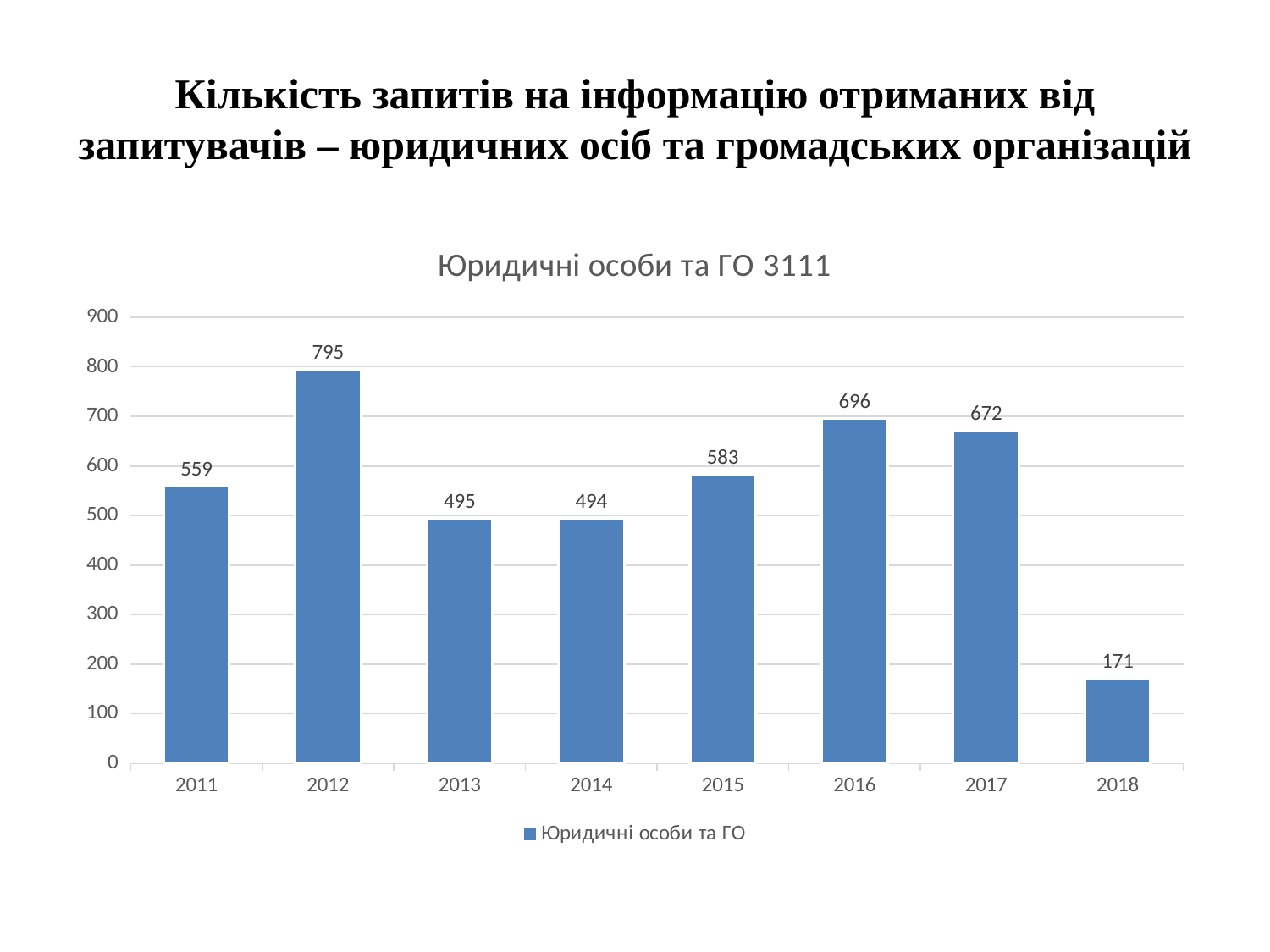
What is the value for 2012? 795 Is the value for 2017 greater or less than 600? greater What is the value for 2018? 171 Which year has the lowest value? 2018 How many years are shown on the x axis? 8 What is the value for 2015? 583 Which is larger, the value for 2011 or the value for 2015? 2015 What is the difference between the values for 2016 and 2017? 24 What is the chart title? Юридичні особи та ГО 3111 Which year has the highest value? 2012 How many series does the legend list? 1 What kind of chart is shown? bar chart